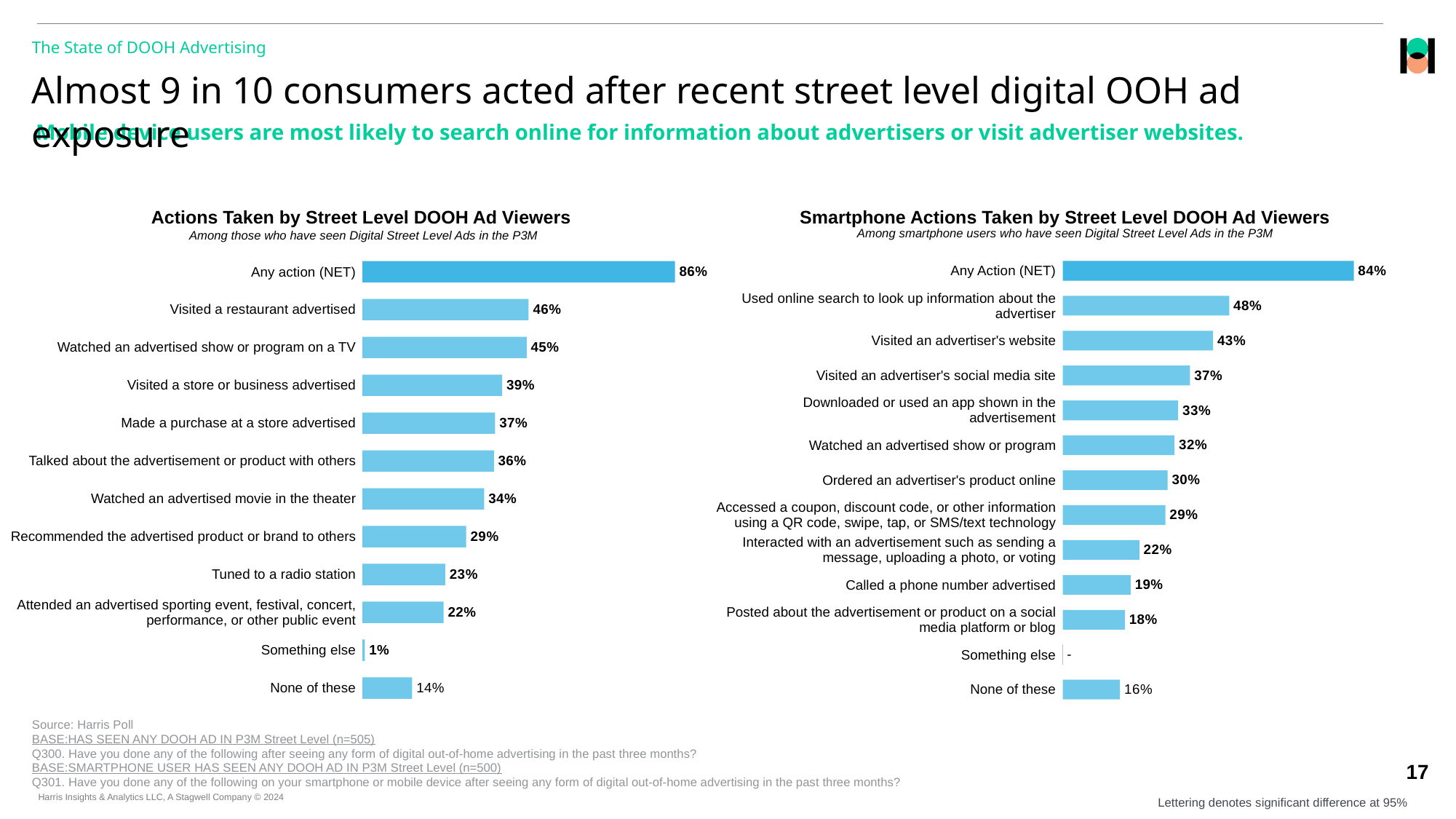
In the 'Actions Taken by Street Level DOOH Ad Viewers' chart, which category has the lowest value? Something else In the 'Smartphone Actions Taken by Street Level DOOH Ad Viewers' chart, which is larger: 'Visited an advertiser's website' or 'Visited an advertiser's social media site'? Visited an advertiser's website In the 'Actions Taken by Street Level DOOH Ad Viewers' chart, what is the value for 'Any action (NET)'? 86% In the 'Smartphone Actions Taken by Street Level DOOH Ad Viewers' chart, what is the difference between 'Any Action (NET)' and 'None of these'? 68% In the 'Smartphone Actions Taken by Street Level DOOH Ad Viewers' chart, what is the value for 'Used online search to look up information about the advertiser'? 48% In the 'Actions Taken by Street Level DOOH Ad Viewers' chart, how many categories are shown? 12 In the 'Actions Taken by Street Level DOOH Ad Viewers' chart, what percentage visited a restaurant advertised? 46% Which chart has the higher 'None of these' value, the left chart or the right chart? The right chart (Smartphone Actions) What type of chart is used for 'Actions Taken by Street Level DOOH Ad Viewers'? Bar chart In the 'Smartphone Actions Taken by Street Level DOOH Ad Viewers' chart, excluding 'Any Action (NET)', which specific action has the highest value? Used online search to look up information about the advertiser In the 'Actions Taken by Street Level DOOH Ad Viewers' chart, what is the difference between 'Visited a store or business advertised' and 'Tuned to a radio station'? 16% In the 'Smartphone Actions Taken by Street Level DOOH Ad Viewers' chart, what percentage called a phone number advertised? 19%